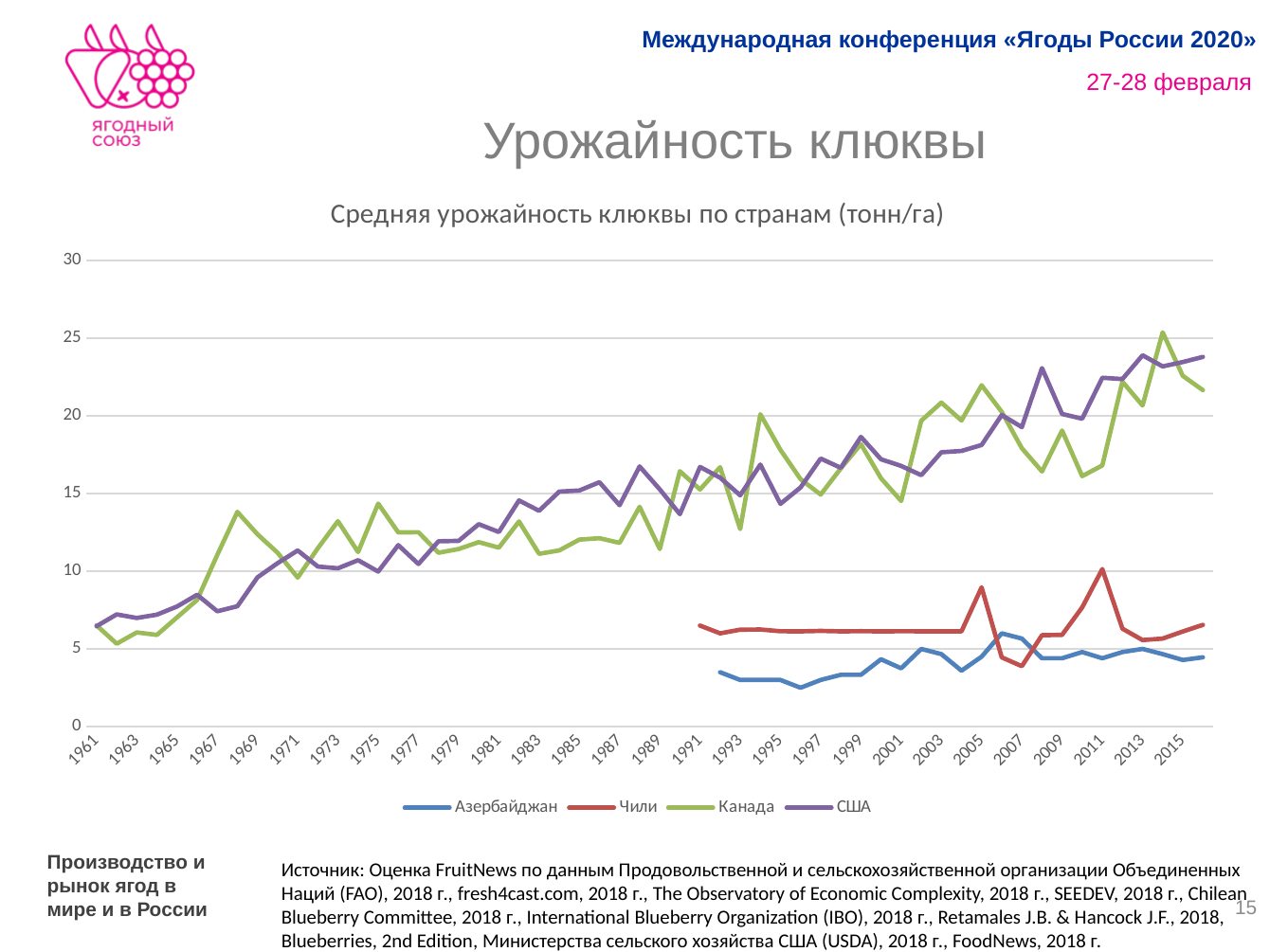
In 2011, which is larger: the value for Чили or the value for Азербайджан? Чили Which series has the highest value in 2013? США How many series does the legend list? 4 Is the value for США in 2015 greater or less than 20? greater Is the value for Канада in 1961 greater or less than 10? less Which series is drawn in green? Канада Is the value for Канада in 2013 greater or less than 20? greater Which series has the lowest value in 2015? Азербайджан What kind of chart is shown on the slide? line chart Do the values for США generally rise or fall from 1961 to 2015? rise What is the title of the chart? Средняя урожайность клюквы по странам (тонн/га)